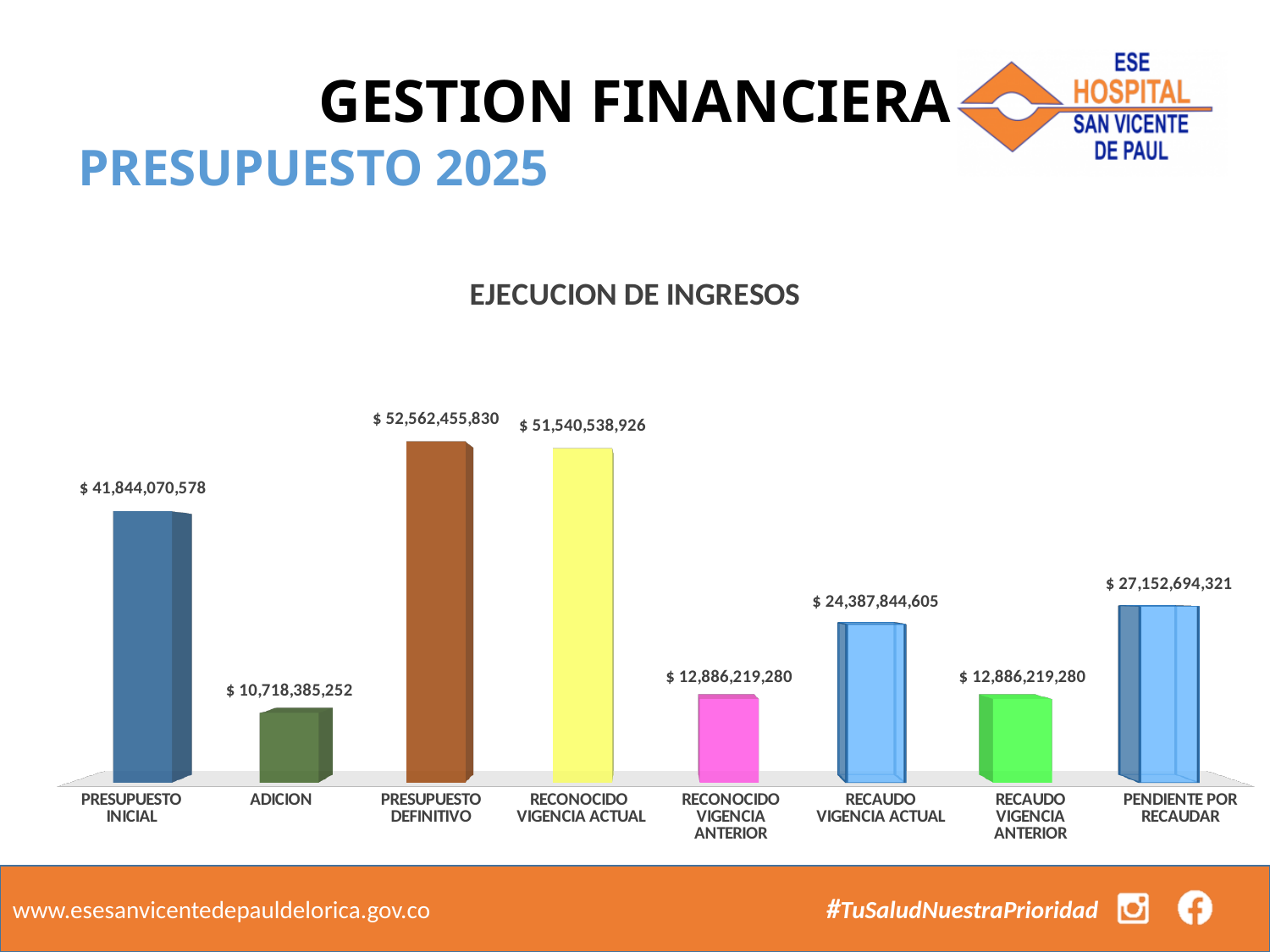
What is the difference between PRESUPUESTO DEFINITIVO and RECONOCIDO VIGENCIA ACTUAL? $ 1,021,916,904 What kind of chart is shown on the slide? Bar chart Which category has the lowest value? ADICION How many categories are shown in the chart? 8 What is the value for PRESUPUESTO INICIAL? $ 41,844,070,578 Which category has the highest value? PRESUPUESTO DEFINITIVO What is the value for RECAUDO VIGENCIA ACTUAL? $ 24,387,844,605 What is the value for ADICION? $ 10,718,385,252 What is the value for RECONOCIDO VIGENCIA ANTERIOR? $ 12,886,219,280 Which is larger, RECAUDO VIGENCIA ACTUAL or PENDIENTE POR RECAUDAR? PENDIENTE POR RECAUDAR What is the value for PENDIENTE POR RECAUDAR? $ 27,152,694,321 What is the difference between PENDIENTE POR RECAUDAR and RECAUDO VIGENCIA ACTUAL? $ 2,764,849,716